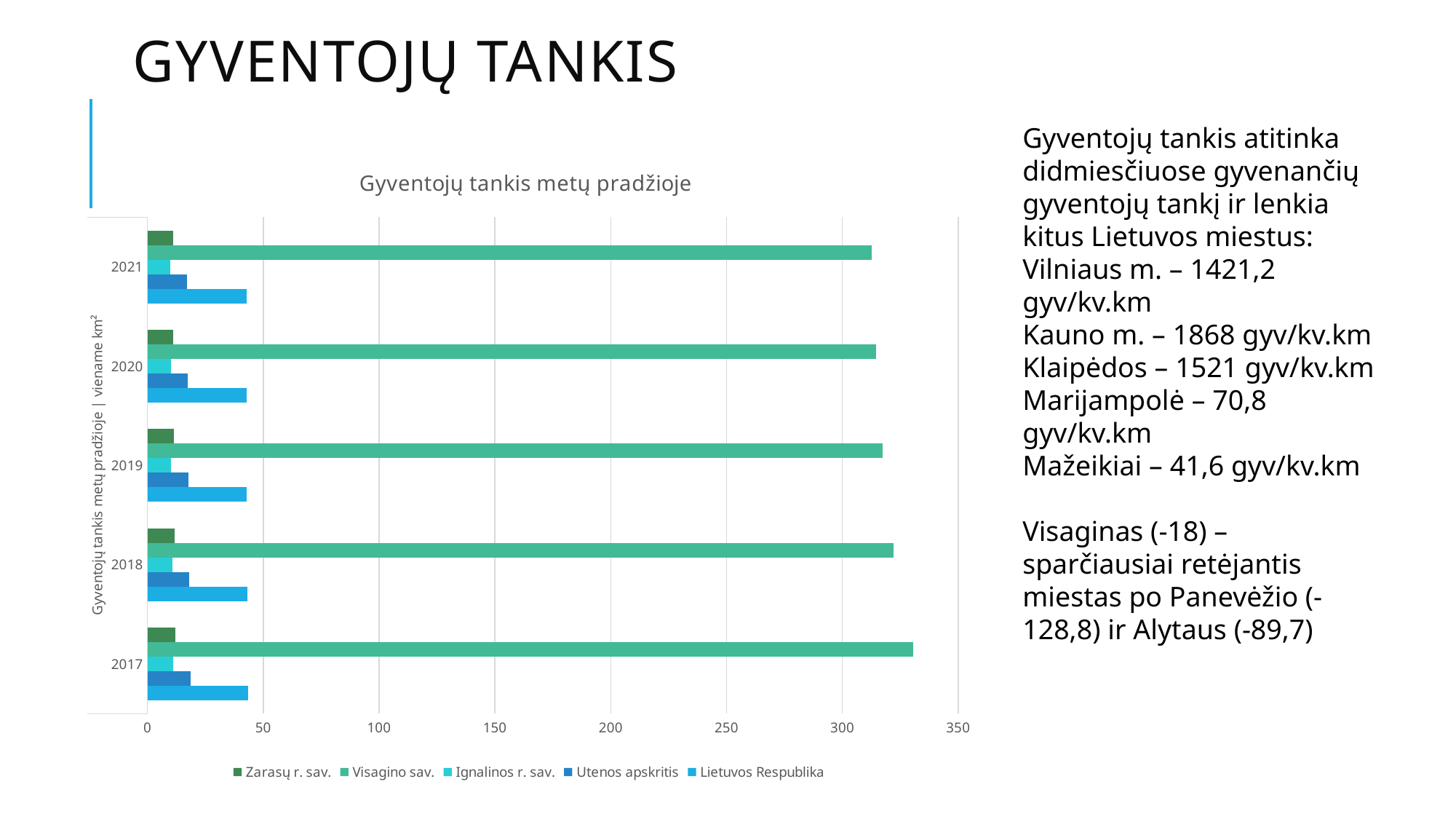
Is the value for Visagino sav. in 2017 greater or less than 300? greater Which series has the lowest value in 2021? Ignalinos r. sav. How many series does the chart legend list? 5 Which is larger in 2020: Lietuvos Respublika or Utenos apskritis? Lietuvos Respublika Which is larger: the value for Visagino sav. in 2017 or in 2021? 2017 Is the value for Utenos apskritis in 2019 greater or less than 50? less What kind of chart is shown on the slide? bar chart Which series has the highest value in 2017? Visagino sav. Does the value for Visagino sav. rise or fall from 2017 to 2021? fall What is the title of the chart? Gyventojų tankis metų pradžioje Is the value for Lietuvos Respublika in 2021 greater or less than 50? less How many years are shown on the chart's vertical axis? 5